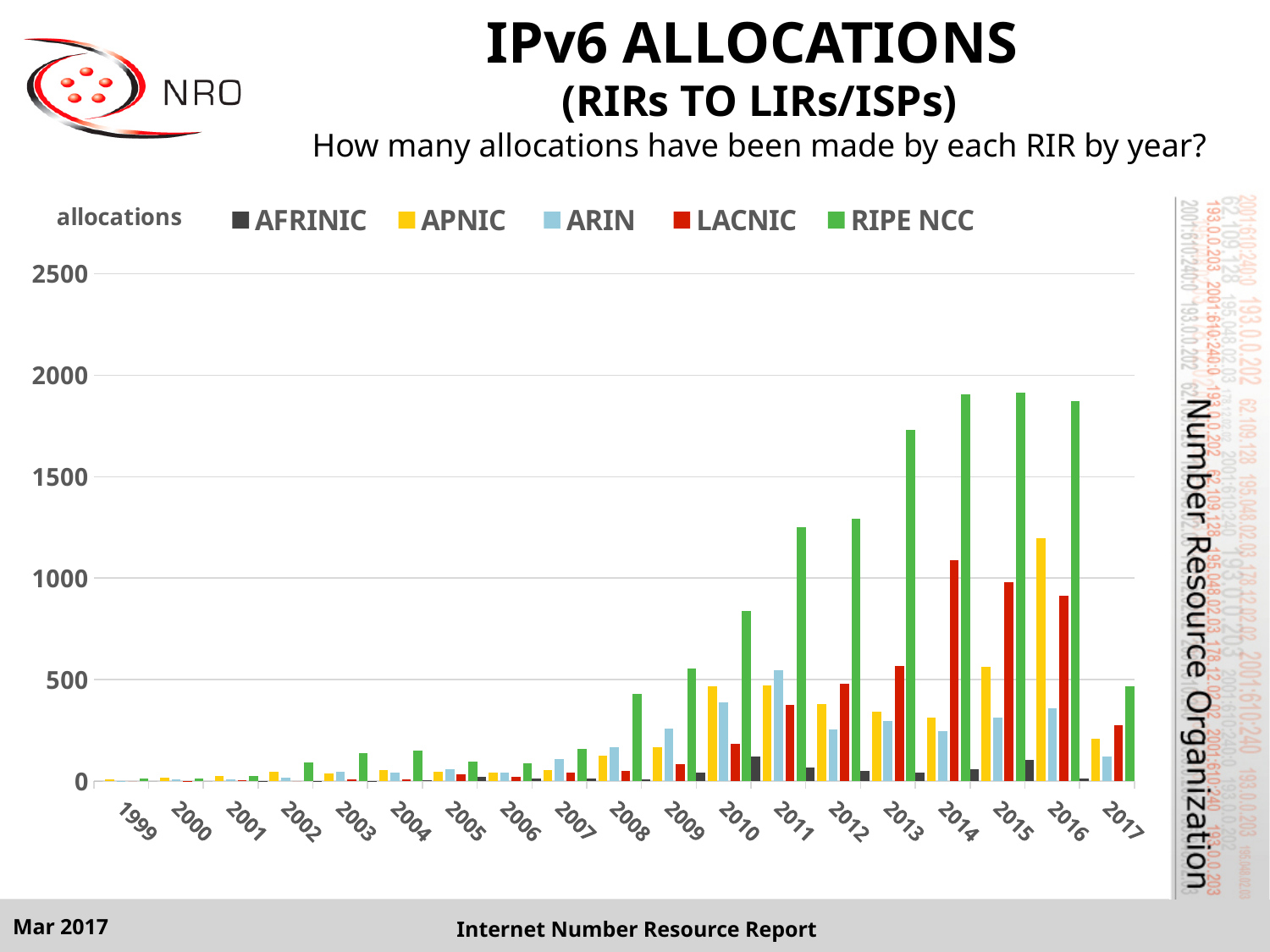
Is the value for RIPE NCC in 2014 greater or less than 1500? greater Is the value for APNIC in 2016 greater or less than 1000? greater What kind of chart is shown on the slide? bar chart In which year does LACNIC reach its highest number of allocations? 2014 Do the RIPE NCC allocations rise or fall from 2009 to 2013? rise Is the value for RIPE NCC in 2017 greater or less than 1000? less Which is larger in 2016, the value for APNIC or the value for LACNIC? APNIC In which year does APNIC reach its highest number of allocations? 2016 How many series does the legend list? 5 Which RIR has the highest number of allocations in 2014? RIPE NCC How many years are shown along the x axis? 19